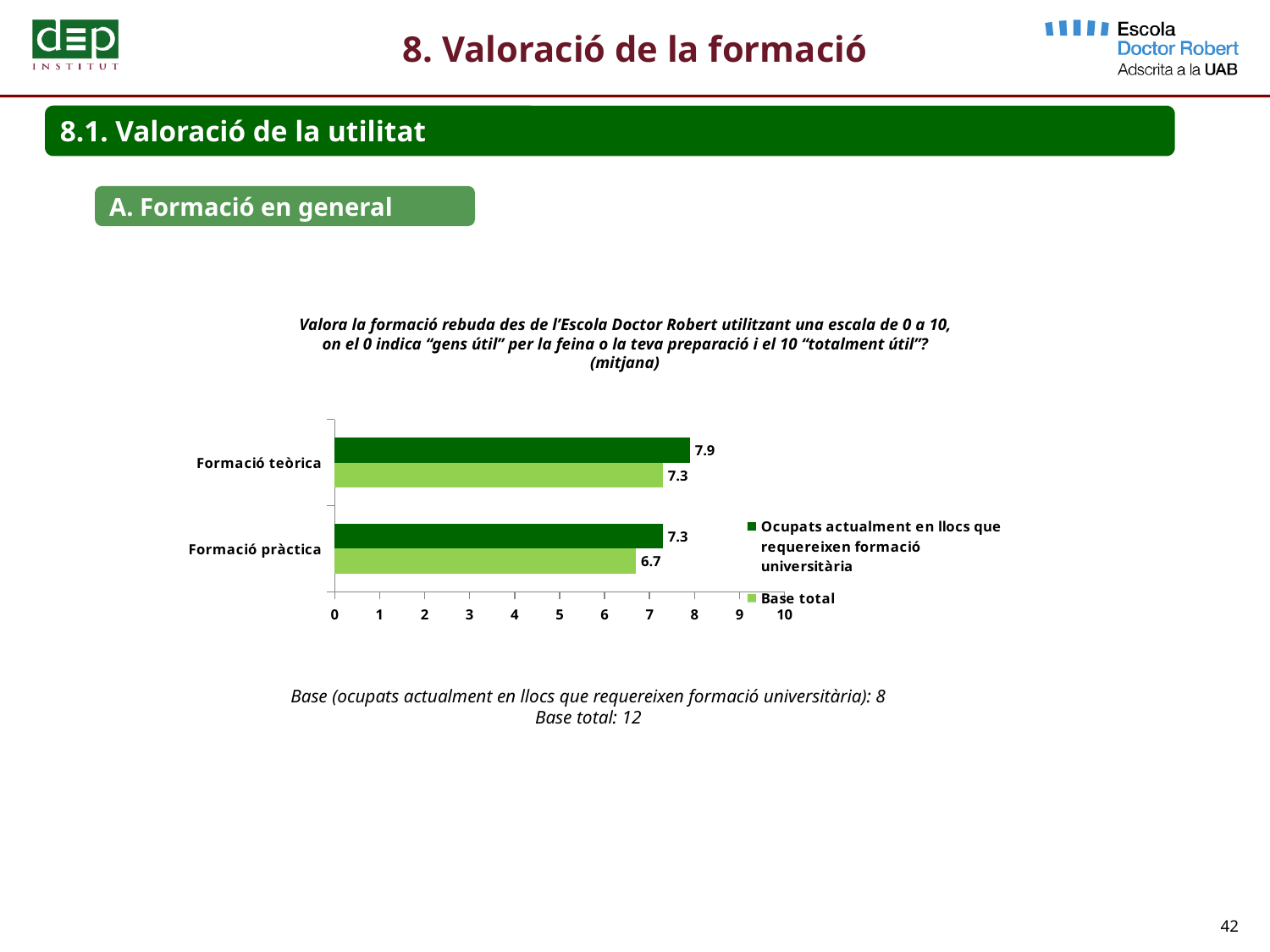
What is the value for Formació teòrica for the 'Base total' series? 7.3 What is the value for Formació teòrica for the series 'Ocupats actualment en llocs que requereixen formació universitària'? 7.9 How many categories are shown on the chart? 2 Which category has the highest value in the 'Base total' series? Formació teòrica Which category has the lowest value in the 'Ocupats actualment en llocs que requereixen formació universitària' series? Formació pràctica What is the value for Formació pràctica for the 'Base total' series? 6.7 What is the value for Formació pràctica for the series 'Ocupats actualment en llocs que requereixen formació universitària'? 7.3 What is the difference between the two series' values for Formació teòrica? 0.6 What is the difference between the two series' values for Formació pràctica? 0.6 How many series does the legend list? 2 What kind of chart is shown on the slide? Bar chart For Formació teòrica, which series has the larger value: 'Ocupats actualment en llocs que requereixen formació universitària' or 'Base total'? Ocupats actualment en llocs que requereixen formació universitària